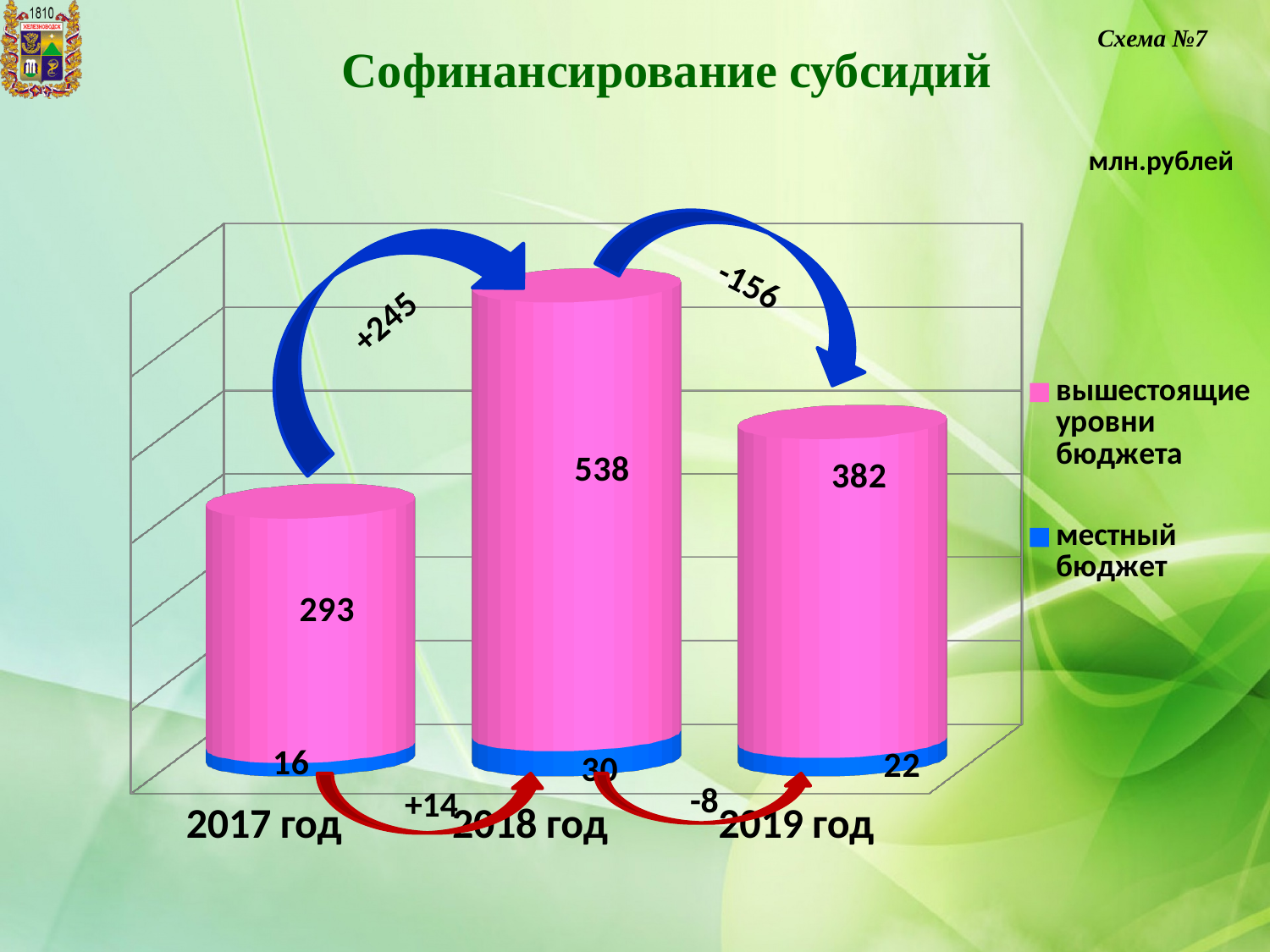
What is the value for вышестоящие уровни бюджета in 2019 год? 382 Which year has the highest value for вышестоящие уровни бюджета? 2018 год What kind of chart is shown on the slide? Stacked bar chart What is the value for местный бюджет in 2017 год? 16 What is the value for вышестоящие уровни бюджета in 2018 год? 538 Which is larger: местный бюджет in 2019 год or in 2018 год? 2018 год How many series does the legend list? 2 Which year has the lowest value for местный бюджет? 2017 год What is the total of the stacked bar for 2019 год? 404 How many years are shown on the x axis? 3 What unit is stated for the values on the chart? млн.рублей What is the difference between the вышестоящие уровни бюджета values for 2018 год and 2017 год? 245